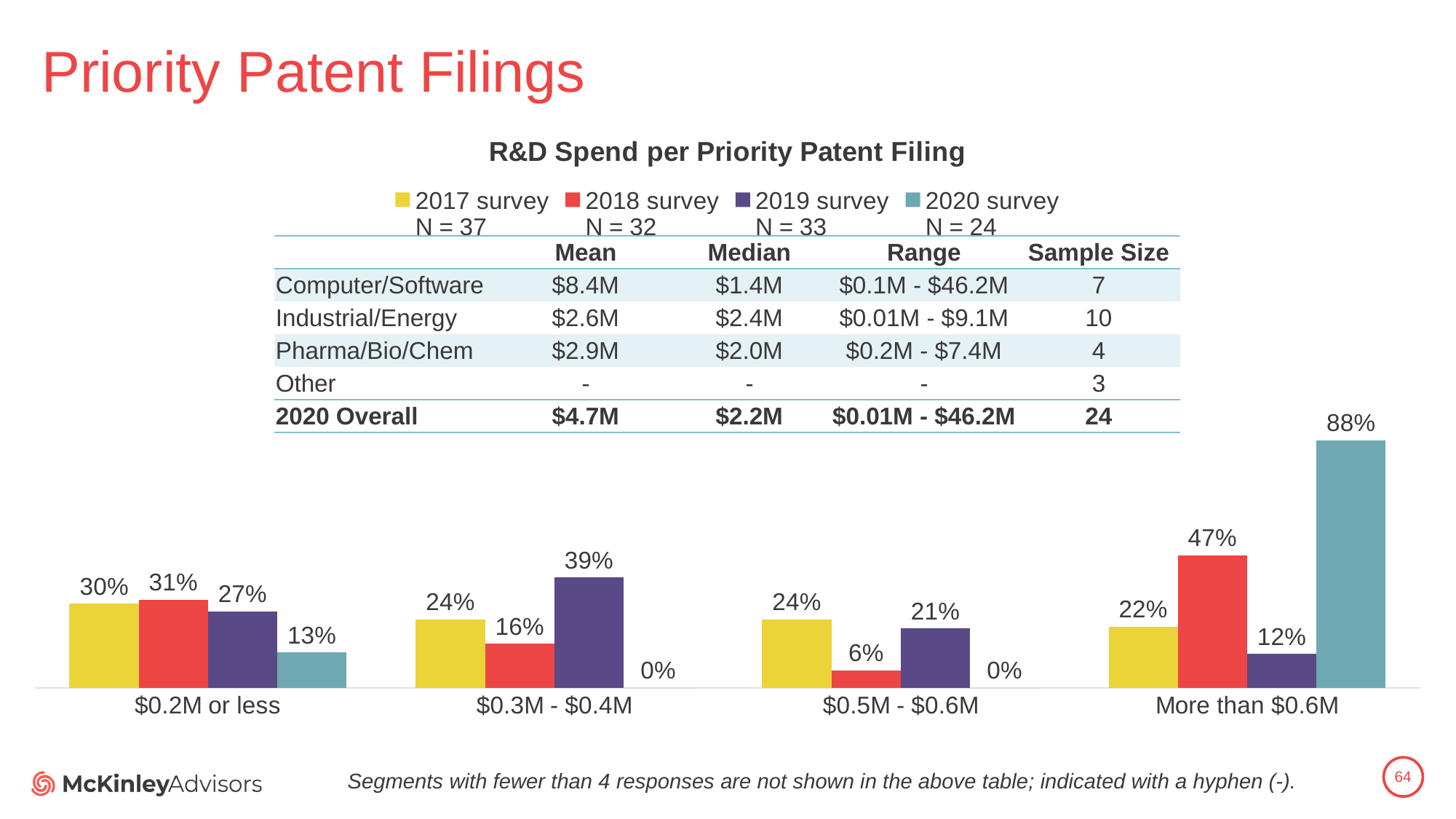
What is the difference between the 2018 survey and 2019 survey values for More than $0.6M? 35% What is the 2019 survey value for $0.3M - $0.4M? 39% What kind of chart is shown? bar chart Which category has the lowest 2018 survey value? $0.5M - $0.6M How many series does the legend list? 4 What is the 2018 survey value for $0.5M - $0.6M? 6% What is the title of the chart? R&D Spend per Priority Patent Filing What is the 2020 survey value for More than $0.6M? 88% Which is larger for $0.2M or less: the 2017 survey value or the 2020 survey value? 2017 survey How many categories are shown on the x axis? 4 Do the 2020 survey values rise or fall from $0.2M or less to $0.5M - $0.6M? fall Which category has the highest 2020 survey value? More than $0.6M